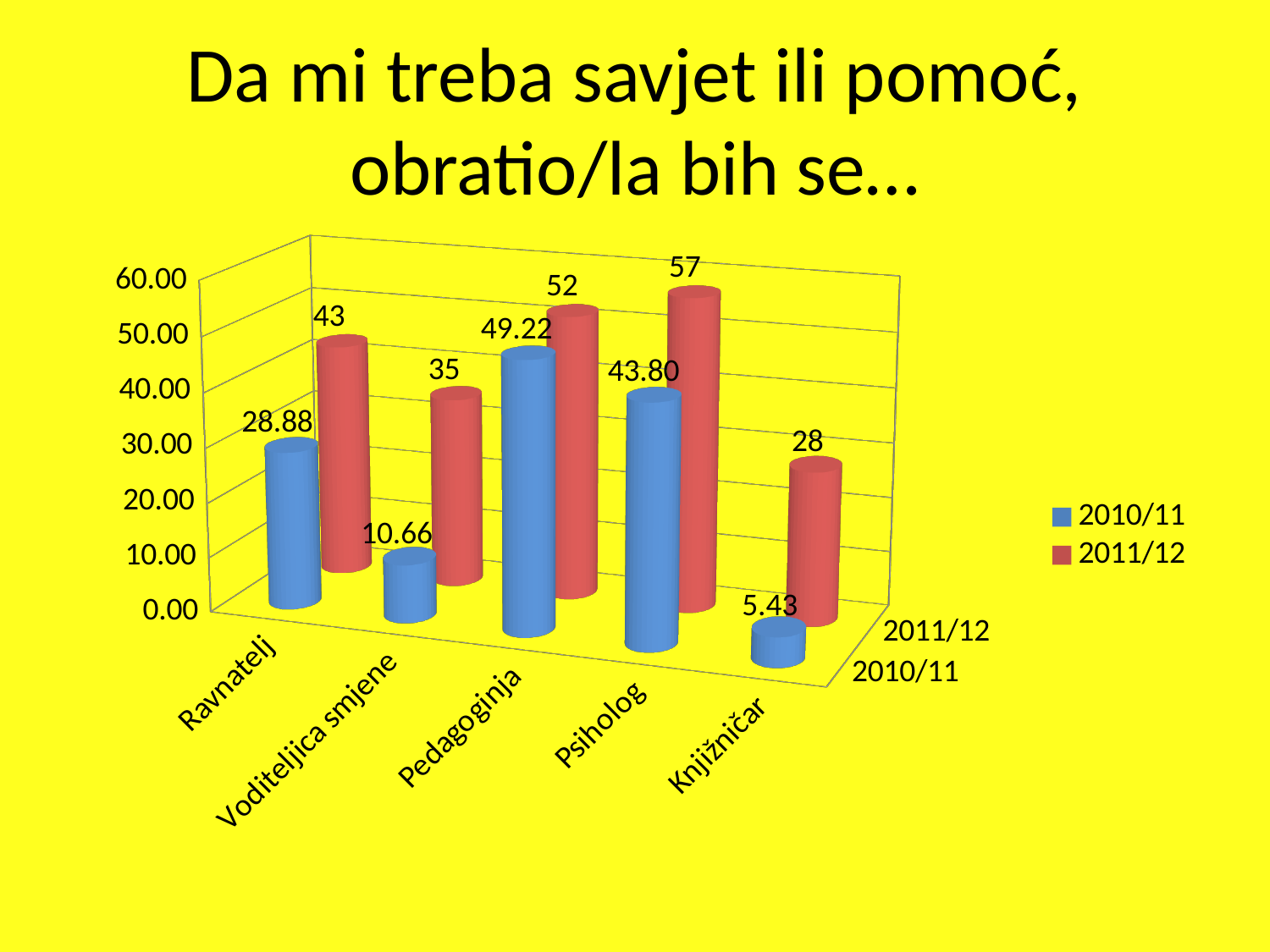
Which is larger for Ravnatelj: the 2010/11 value or the 2011/12 value? 2011/12 What is the value for Psiholog in the 2011/12 series? 57 Which category has the lowest value in the 2010/11 series? Knjižničar What kind of chart is shown on the slide? Bar chart How many series does the legend list? 2 What is the title of the slide? Da mi treba savjet ili pomoć, obratio/la bih se… What is the value for Knjižničar in the 2010/11 series? 5.43 How many categories are shown on the x axis? 5 What is the value for Voditeljica smjene in the 2011/12 series? 35 What is the difference between the 2011/12 and 2010/11 values for Pedagoginja? 2.78 Which category has the highest value in the 2011/12 series? Psiholog What is the value for Ravnatelj in the 2010/11 series? 28.88